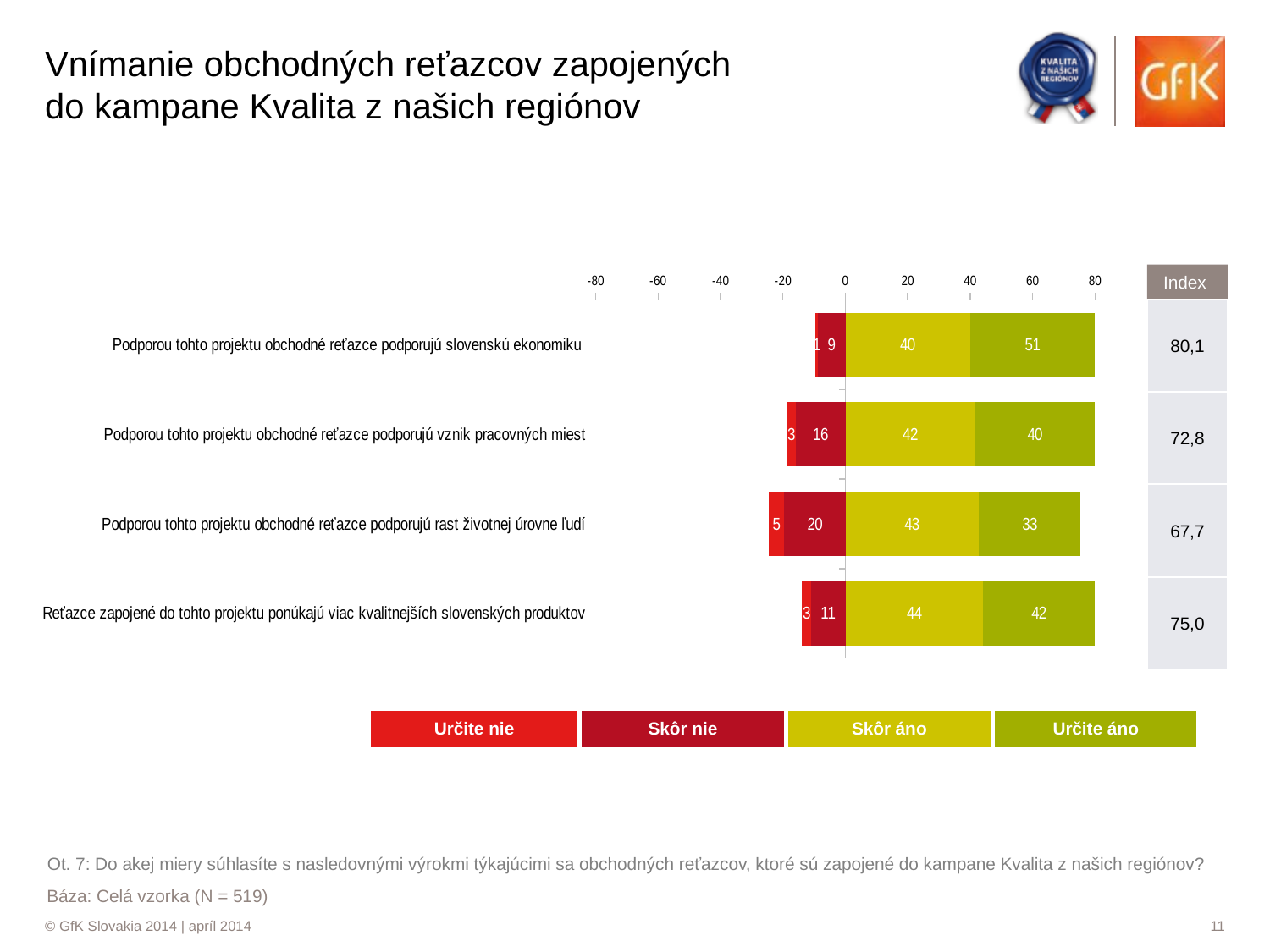
Which statement has the lowest Index value? Podporou tohto projektu obchodné reťazce podporujú rast životnej úrovne ľudí Which is larger: the 'Skôr nie' value for 'podporujú vznik pracovných miest' or for 'ponúkajú viac kvalitnejších slovenských produktov'? podporujú vznik pracovných miest What is the Index value shown for 'Podporou tohto projektu obchodné reťazce podporujú vznik pracovných miest'? 72,8 How many series does the legend list? 4 What is the 'Skôr nie' value for 'Podporou tohto projektu obchodné reťazce podporujú rast životnej úrovne ľudí'? 20 What is the total of the 'Skôr áno' and 'Určite áno' values for 'Podporou tohto projektu obchodné reťazce podporujú vznik pracovných miest'? 82 What is the 'Určite áno' value for 'Podporou tohto projektu obchodné reťazce podporujú slovenskú ekonomiku'? 51 How many statements (categories) are plotted in the chart? 4 What is the 'Skôr áno' value for 'Reťazce zapojené do tohto projektu ponúkajú viac kvalitnejších slovenských produktov'? 44 What kind of chart is shown on the slide? Stacked bar chart What is the difference between the 'Určite áno' values for 'podporujú slovenskú ekonomiku' (51) and 'podporujú rast životnej úrovne ľudí' (33)? 18 Which statement has the highest 'Určite áno' value? Podporou tohto projektu obchodné reťazce podporujú slovenskú ekonomiku